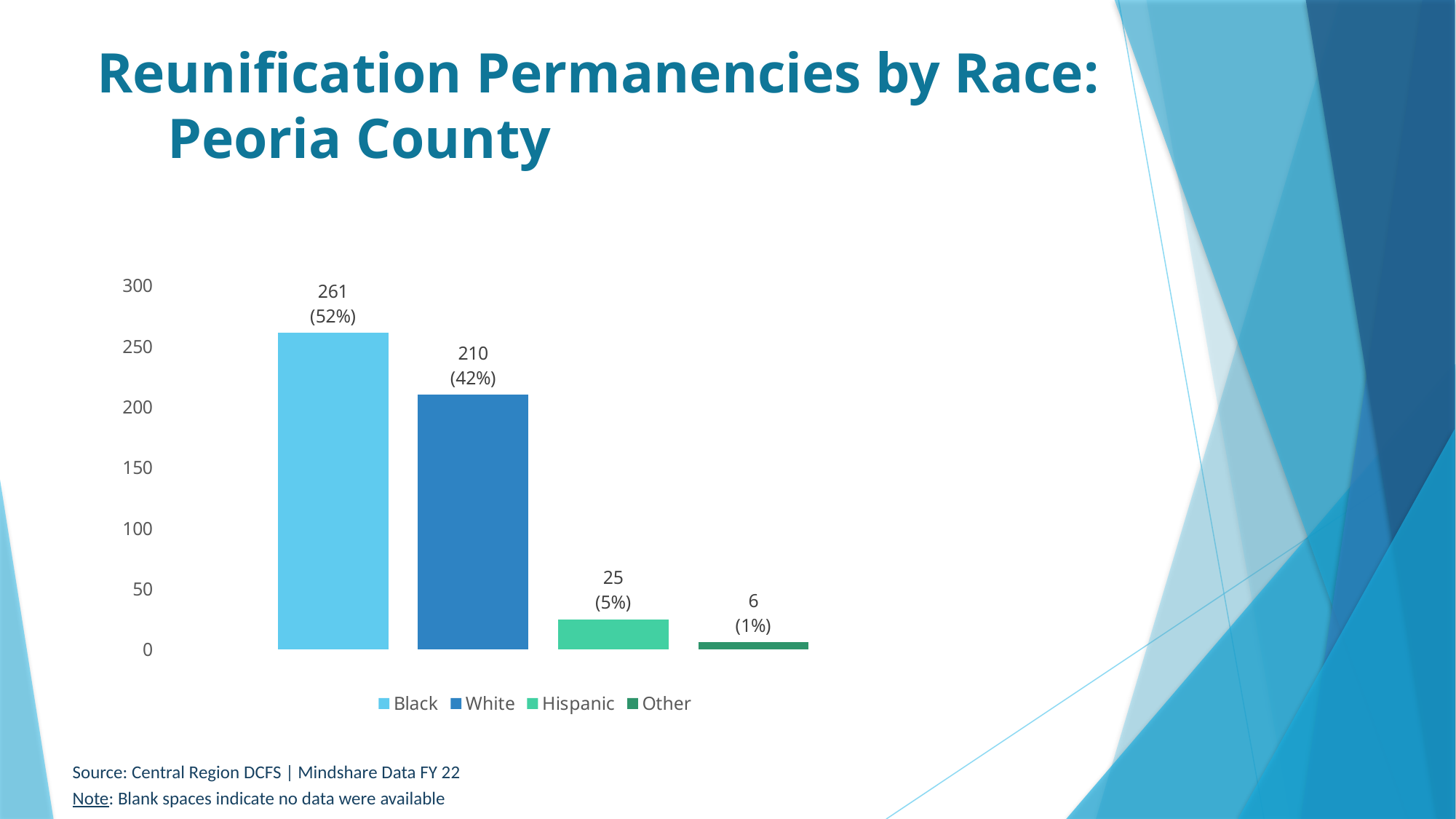
What is the source cited for the chart data? Central Region DCFS | Mindshare Data FY 22 What is the difference between the Black and White values? 51 What percentage is shown for Hispanic? 5% Is the value for White greater or less than 200? greater What kind of chart is shown on the slide? bar chart Which race category has the lowest number of reunification permanencies? Other What is the number of reunification permanencies for White in Peoria County? 210 Which race category has the highest number of reunification permanencies? Black What is the number of reunification permanencies for Black in Peoria County? 261 What is the value shown for Other? 6 Which is larger, the value for Hispanic or the value for Other? Hispanic How many race categories are plotted in the chart? 4